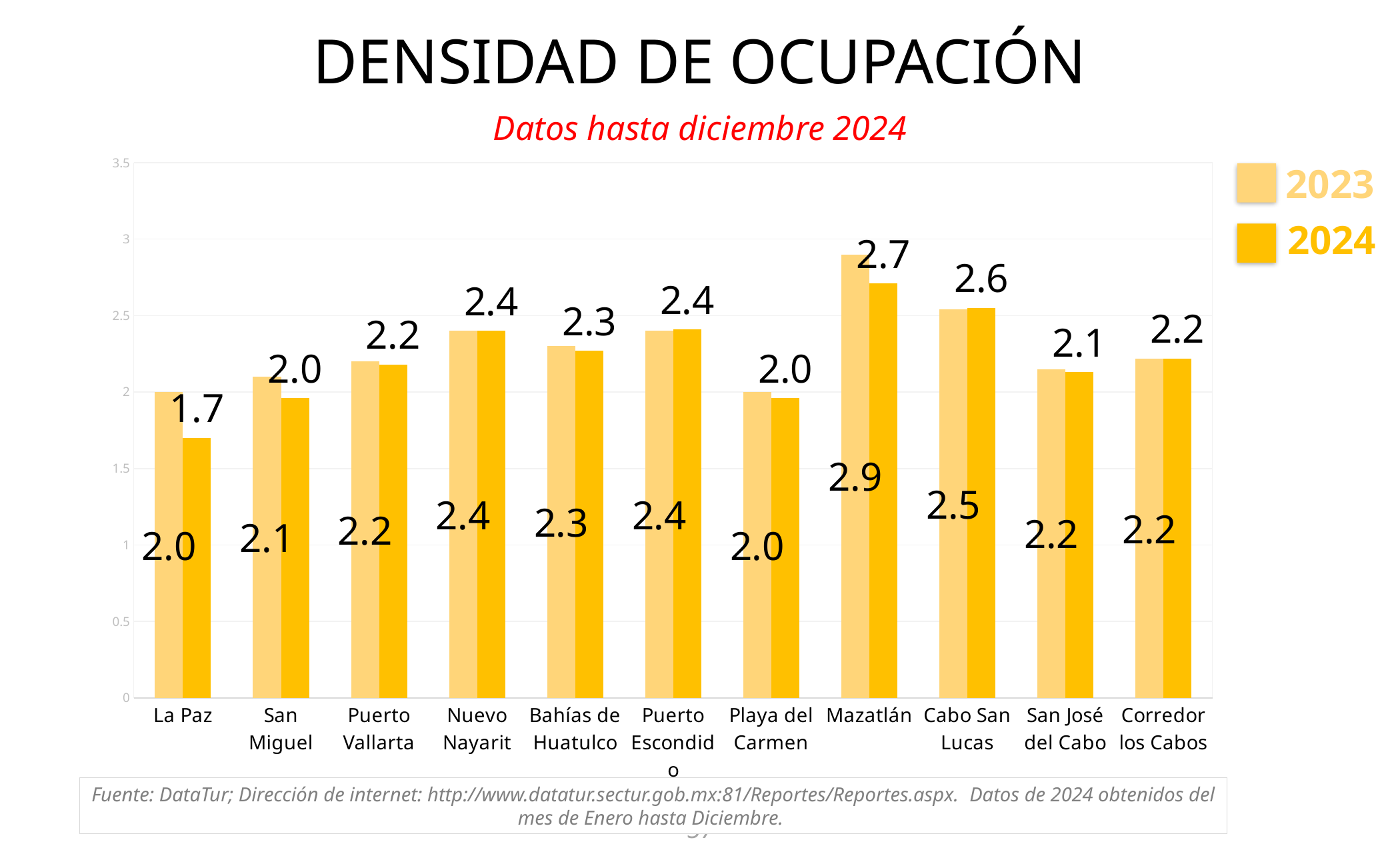
Which is larger for La Paz, the 2023 value or the 2024 value? 2023 Which destination has the highest 2024 value? Mazatlán How many destinations are shown on the x axis? 11 What is the 2023 value for Mazatlán? 2.9 What kind of chart is shown on the slide? Bar chart What is the 2023 value for San Miguel? 2.1 What is the difference between the 2023 and 2024 values for Mazatlán? 0.2 What is the title of the chart? DENSIDAD DE OCUPACIÓN What is the 2024 value for La Paz? 1.7 How many series does the legend list? 2 Which destination has the lowest 2024 value? La Paz What is the 2024 value for Cabo San Lucas? 2.6